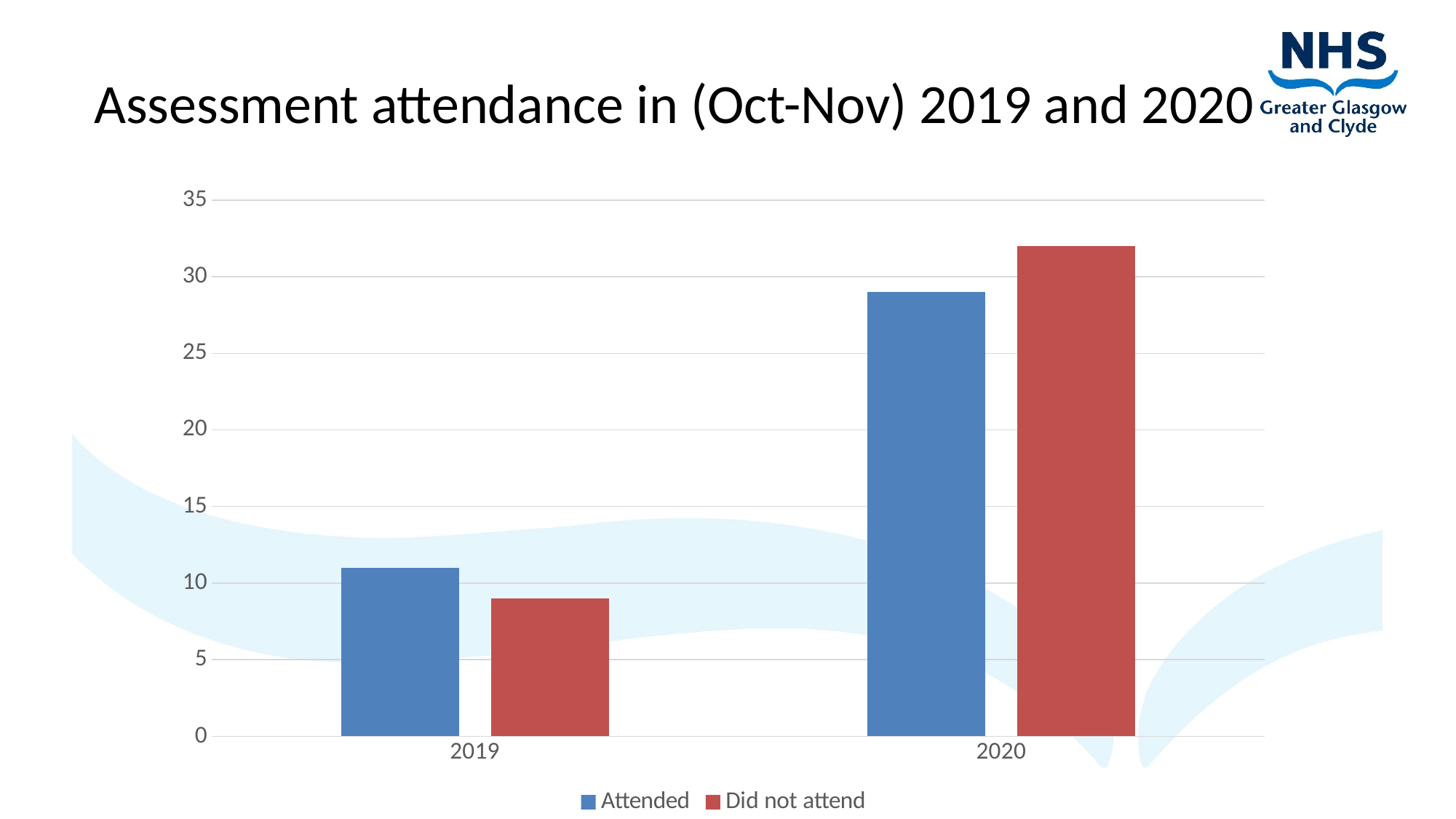
Is the value for Did not attend in 2019 greater or less than 10? less Is the value for Attended in 2020 greater or less than 30? less Is the value for Attended in 2019 greater or less than 10? greater What kind of chart is shown on the slide? bar chart Does the Attended value rise or fall from 2019 to 2020? rise In 2019, which is larger: Attended or Did not attend? Attended In 2020, which is larger: Attended or Did not attend? Did not attend Which bar is the tallest on the chart? Did not attend in 2020 How many series does the legend list? 2 How many year categories are shown on the x axis? 2 What colour represents the Did not attend series? red